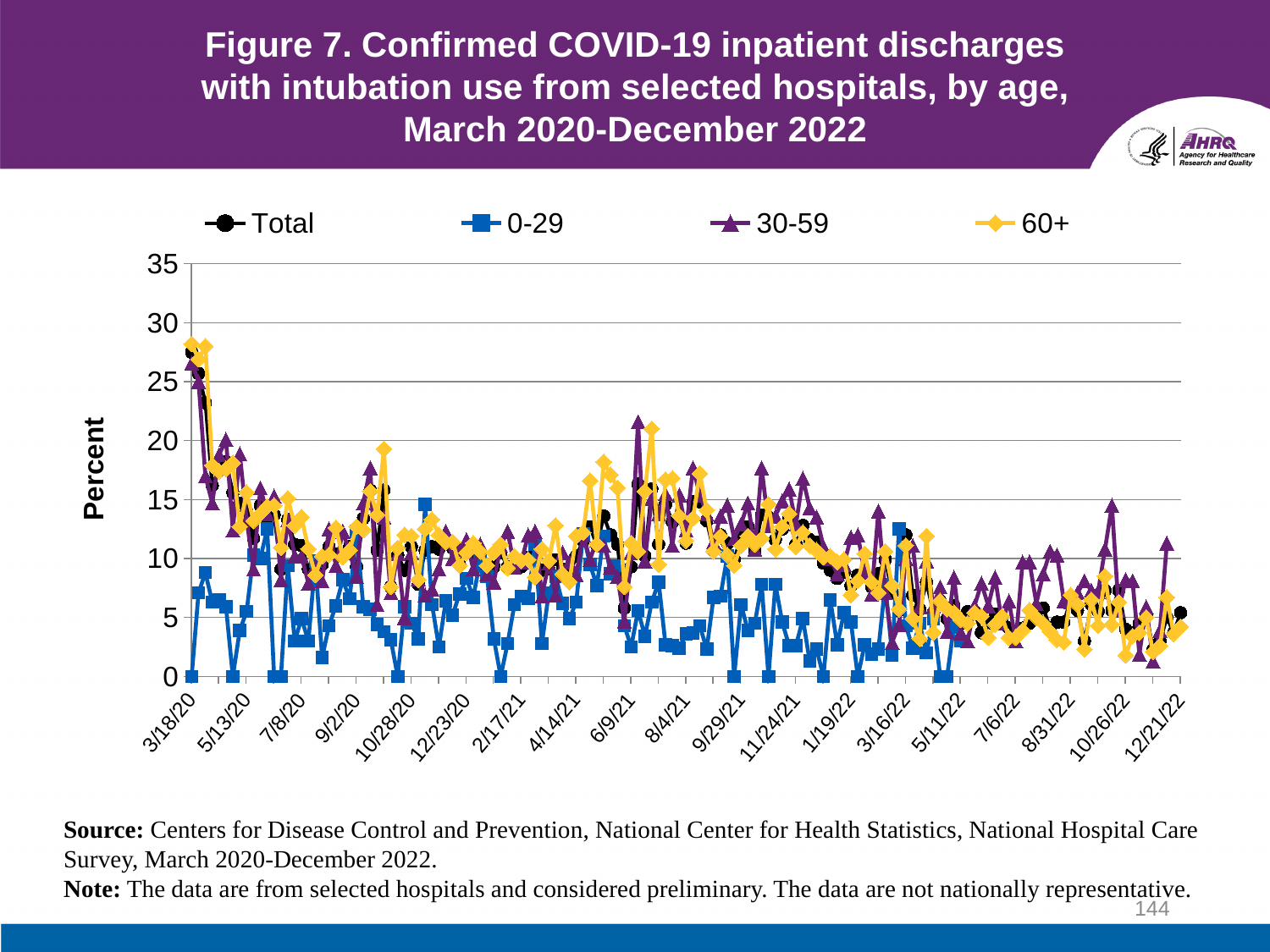
At 3/18/20, which is larger: the 0-29 series or the 60+ series? 60+ How many series does the legend list? 4 What is the highest value shown on the vertical axis? 35 Which series is generally the lowest across the chart? 0-29 Is the value for the 60+ series at 3/18/20 greater or less than 25? greater Is the value for the 60+ series at 10/26/22 greater or less than 5? less What is the label on the vertical axis? Percent What kind of chart is shown on the slide? Line chart Overall, does the Total series rise or fall from March 2020 to December 2022? Fall Is the value for the 0-29 series at 3/18/20 greater or less than 5? less How many date labels are shown on the horizontal axis? 19 Which age groups are listed in the legend besides Total? 0-29, 30-59, 60+